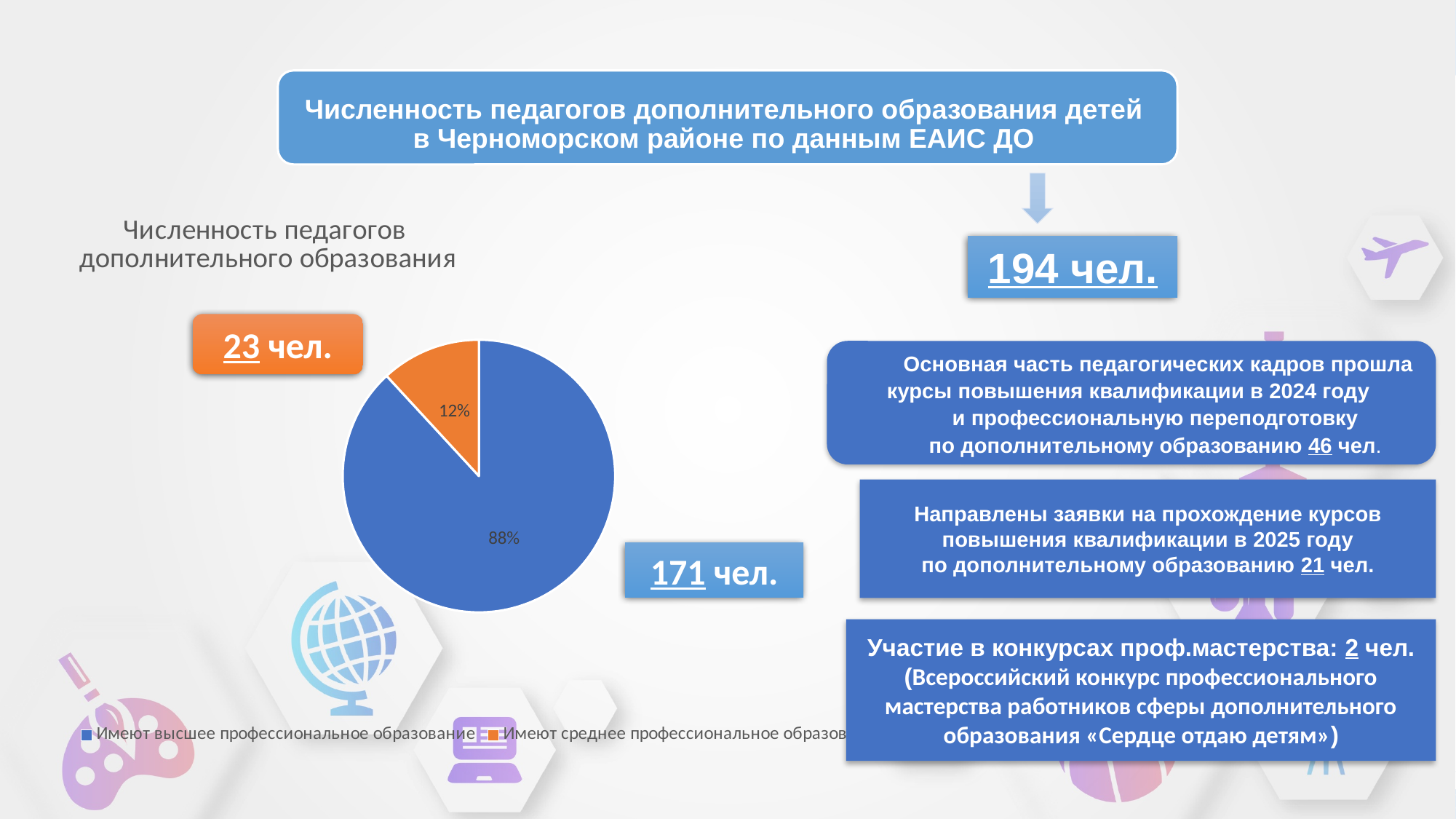
How many slices does the pie chart have? 2 Is the share for "Имеют среднее профессиональное образование" greater or less than 50%? less Which category has the smallest slice in the pie chart? Имеют среднее профессиональное образование Which is larger in the pie chart: the slice for higher professional education or the slice for secondary professional education? Имеют высшее профессиональное образование Which category has the largest slice in the pie chart? Имеют высшее профессиональное образование How many entries does the legend of the pie chart list? 2 By how many percentage points does the 88% slice exceed the 12% slice? 76 What kind of chart is shown on the slide? pie chart What is the title of the pie chart? Численность педагогов дополнительного образования What share of the pie is labelled for "Имеют высшее профессиональное образование"? 88% What colour is the slice for "Имеют среднее профессиональное образование"? orange What share of the pie is labelled for "Имеют среднее профессиональное образование"? 12%